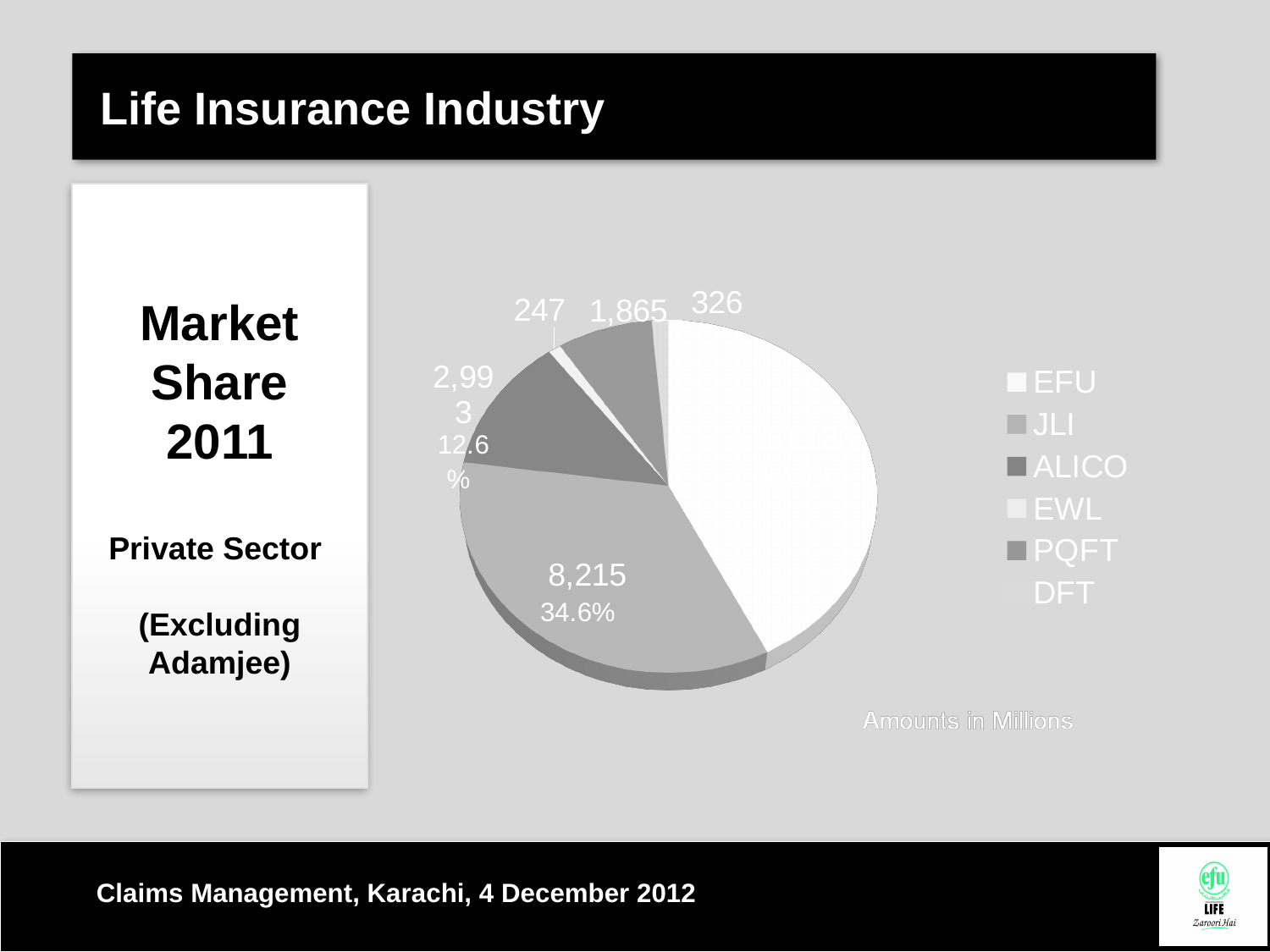
What is the difference between the values for JLI and ALICO? 5,222 What kind of chart is shown on the slide? pie chart Which legend entry is listed first in the pie chart's legend? EFU What share of the pie does JLI hold? 34.6% What share of the pie does ALICO hold? 12.6% How many entries does the legend of the pie chart list? 6 What is the value shown for ALICO in the pie chart? 2,993 What is the value shown for JLI in the pie chart? 8,215 How many slices does the pie chart have? 6 In what units are the amounts in the pie chart expressed, according to the note below it? Amounts in Millions Which company has the largest slice of the pie chart? EFU Which is larger in the pie chart, JLI or ALICO? JLI